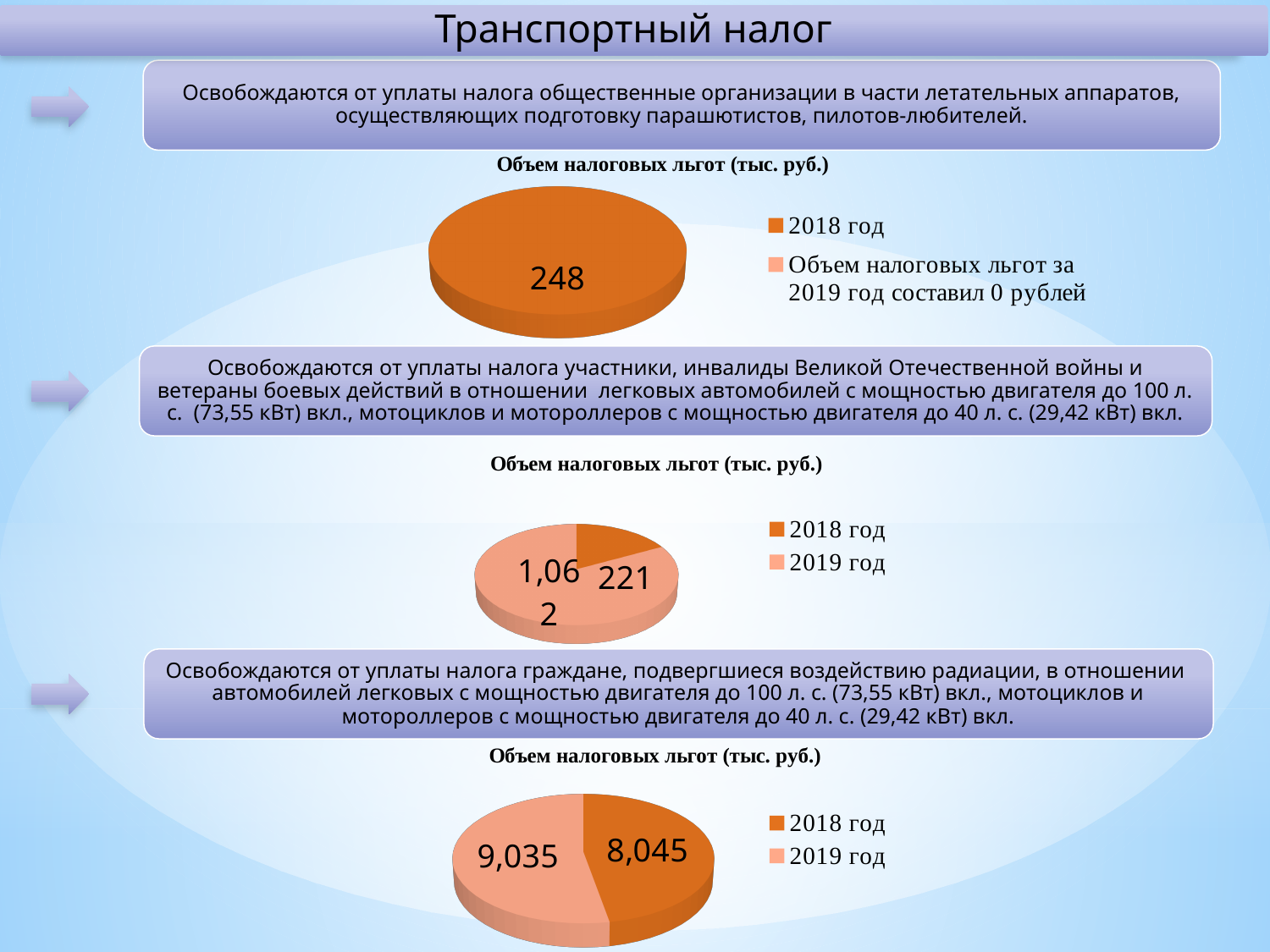
In the middle pie chart, which year has the largest slice? 2019 год In the middle pie chart, which year has the smallest slice? 2018 год In the bottom pie chart, which year has the larger value, 2018 год or 2019 год? 2019 год In the top pie chart, what is the value shown for 2018 год? 248 What type of chart is the bottom chart on the slide? Pie chart In the bottom pie chart, what is the value for 2018 год? 8,045 How many entries does the legend of the bottom pie chart list? 2 How many slices are visible in the top pie chart? 1 In the middle pie chart, what is the value for 2019 год? 1,062 According to the legend of the top pie chart, what was the volume of tax benefits for 2019? 0 рублей In the middle pie chart, what is the value for 2018 год? 221 In the bottom pie chart, what is the value for 2019 год? 9,035